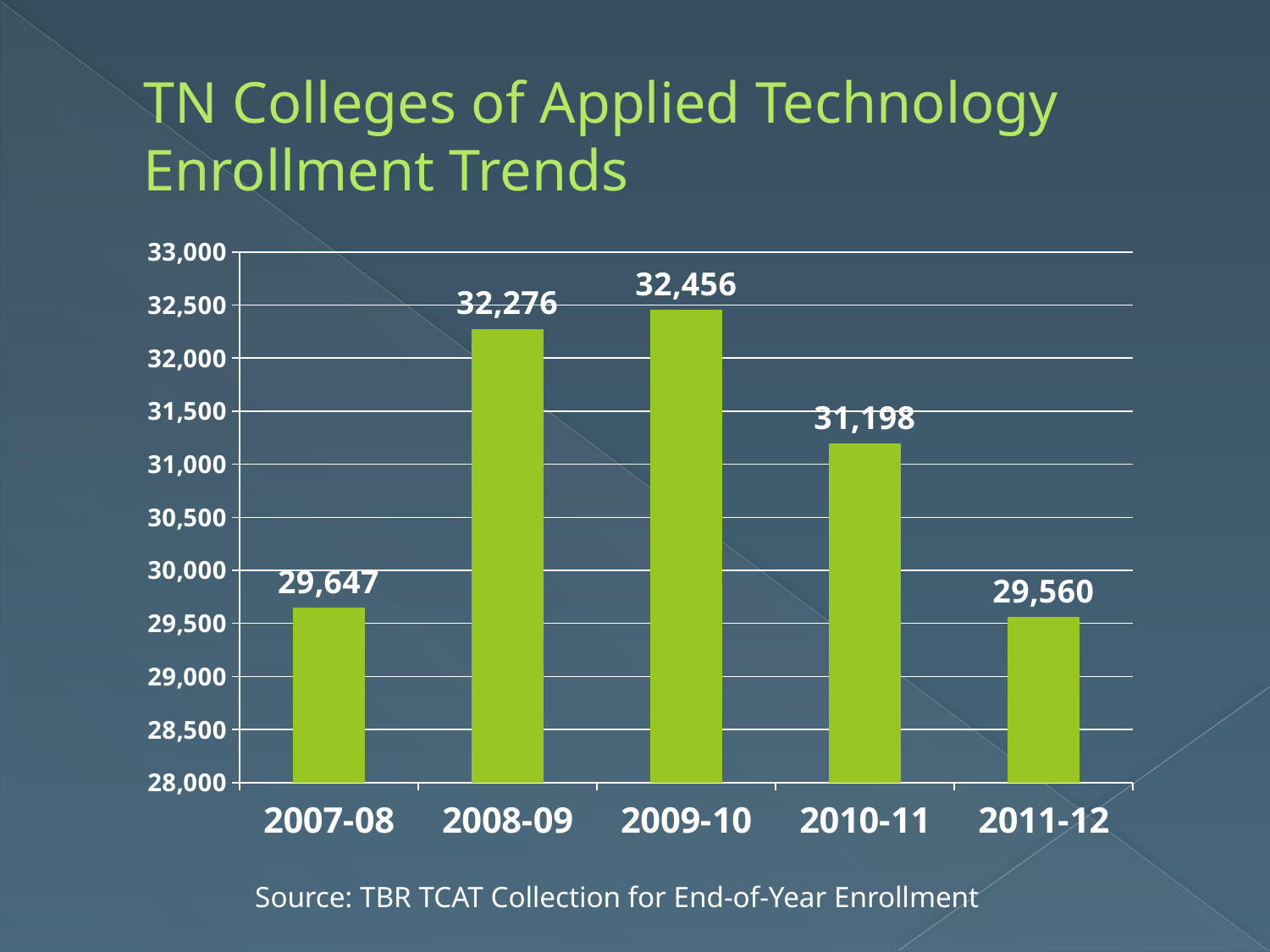
What kind of chart is shown on the slide? bar chart What is the difference in enrollment between 2008-09 and 2007-08? 2,629 What is the difference in enrollment between 2009-10 and 2010-11? 1,258 What is the enrollment value for 2007-08? 29,647 Which year has the lowest enrollment? 2011-12 What is the enrollment value for 2009-10? 32,456 How many academic years are shown on the chart? 5 What is the source cited below the chart? TBR TCAT Collection for End-of-Year Enrollment Is the enrollment value for 2011-12 greater or less than 30,000? less Which year has the highest enrollment? 2009-10 What is the enrollment value for 2010-11? 31,198 Which is larger, the enrollment for 2008-09 or for 2010-11? 2008-09